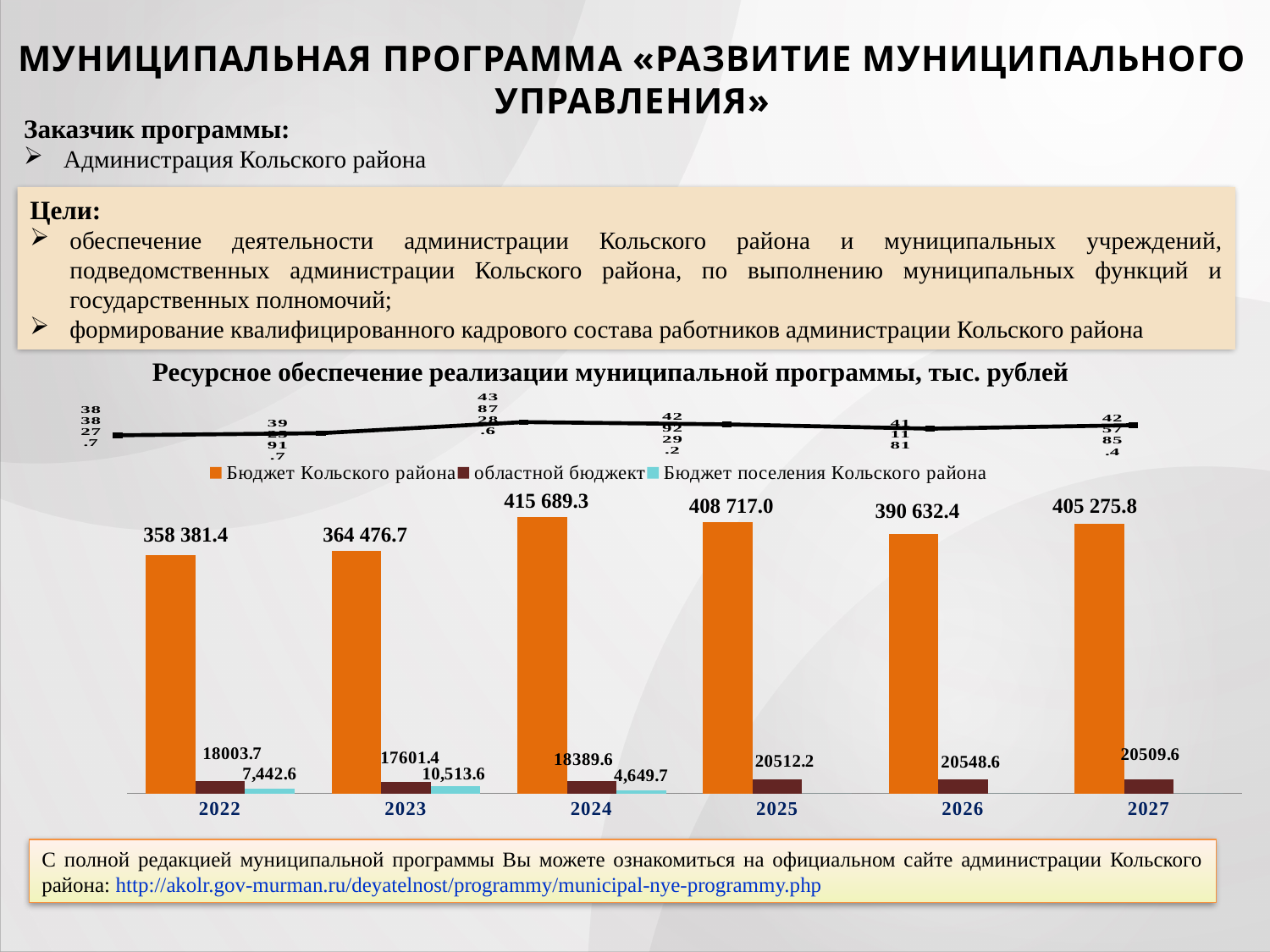
What is the difference between областной бюджект in 2026 and in 2025? 36.4 What is the title of the chart? Ресурсное обеспечение реализации муниципальной программы, тыс. рублей In which year is Бюджет Кольского района the lowest? 2022 In which year is Бюджет поселения Кольского района the lowest among the years where it is shown? 2024 How many years are shown on the x axis of the chart? 6 Which is larger, Бюджет Кольского района in 2025 or in 2027? 2025 What is the value for областной бюджект in 2022? 18003.7 What is the value for Бюджет поселения Кольского района in 2023? 10,513.6 How many series does the legend of the chart list? 3 What kind of chart is used to show the budget values? bar chart What is the value for Бюджет Кольского района in 2024? 415 689.3 In which year is Бюджет Кольского района the highest? 2024